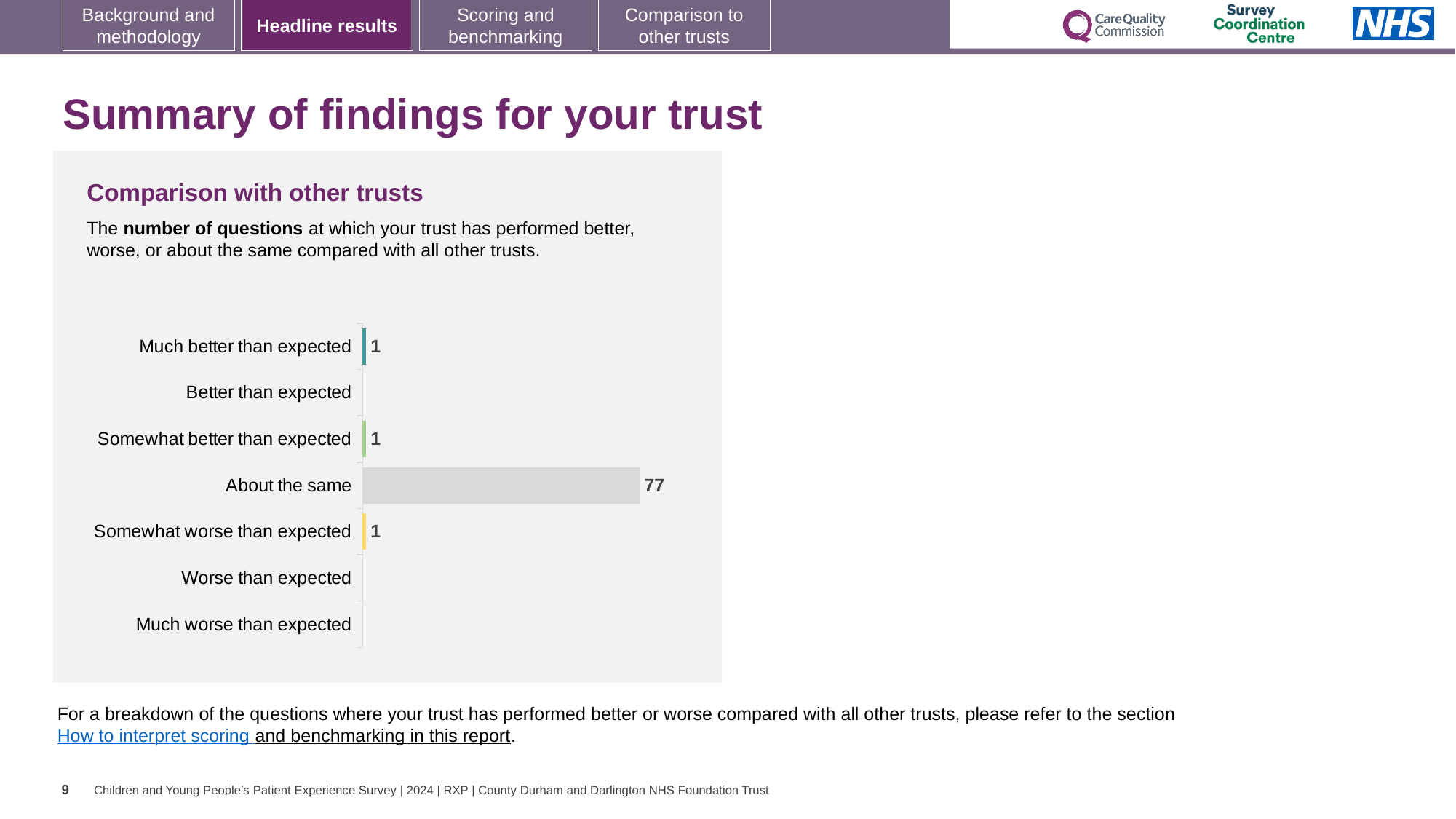
Which is larger, the value for 'About the same' or the value for 'Somewhat worse than expected'? About the same What is the value for 'Much better than expected'? 1 What is the total number of questions across all categories shown on the chart? 80 How many questions are in the 'About the same' category? 77 What is the value for 'Somewhat better than expected'? 1 Which category has the highest number of questions? About the same What is the value for 'Somewhat worse than expected'? 1 What colour is the bar for 'Somewhat worse than expected'? Yellow How many categories are listed on the chart's vertical axis? 7 What is the title of the chart section on the slide? Comparison with other trusts What kind of chart is shown on the slide? Bar chart What is the difference between the 'About the same' value and the 'Much better than expected' value? 76